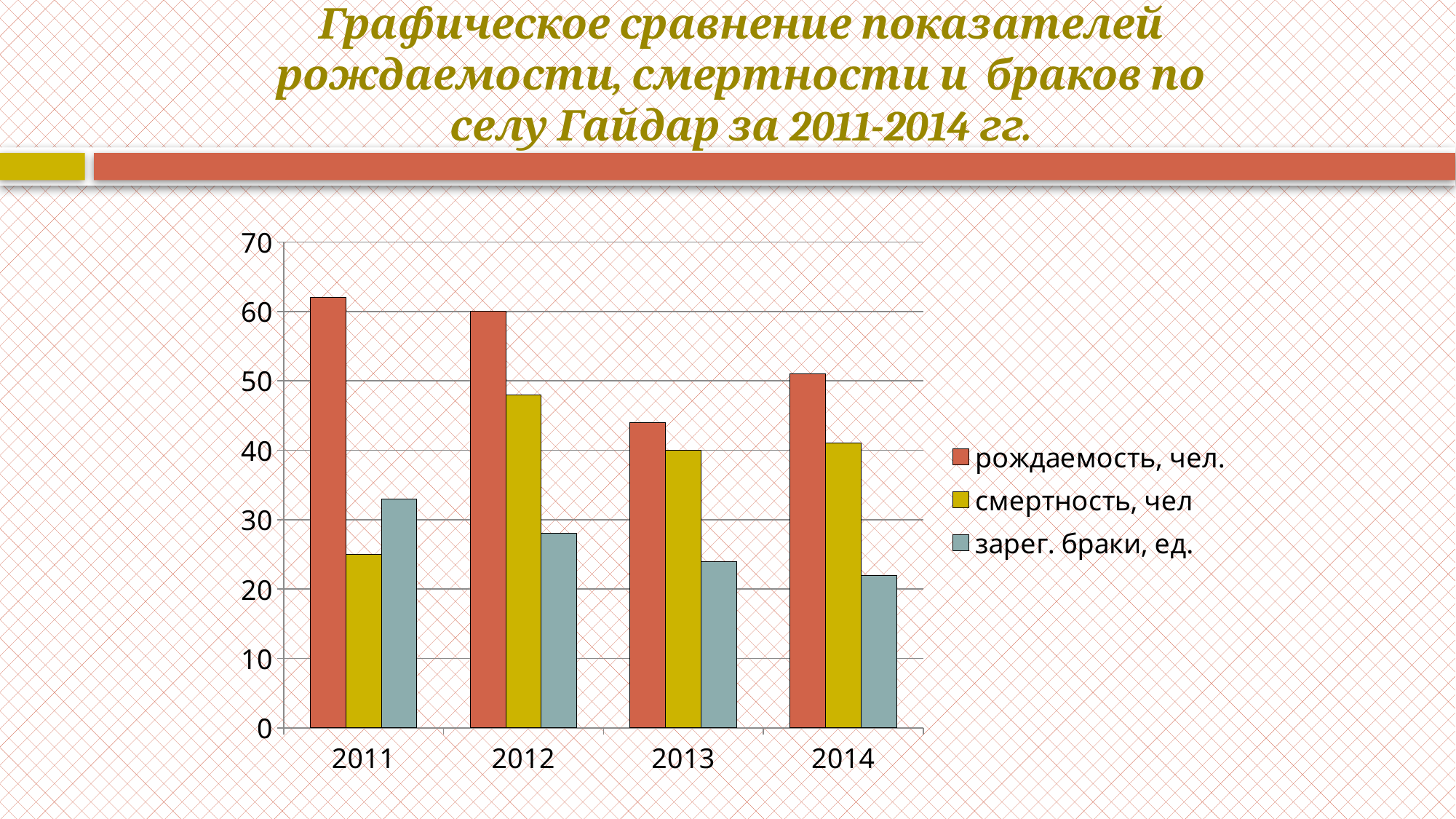
How many series does the legend list? 3 Do the values for зарег. браки, ед. rise or fall from 2011 to 2014? fall Is the value for рождаемость, чел. in 2011 greater or less than 60? greater How many years are shown on the x axis? 4 In which year is рождаемость, чел. the highest? 2011 In which year is рождаемость, чел. the lowest? 2013 Which is larger: смертность, чел in 2012 or in 2013? 2012 What kind of chart is shown on the slide? bar chart Is the value for смертность, чел in 2011 greater or less than 30? less Is the value for зарег. браки, ед. in 2011 greater or less than 30? greater In 2014, which is larger: рождаемость, чел. or смертность, чел? рождаемость, чел. Which series is shown in yellow in the legend? смертность, чел